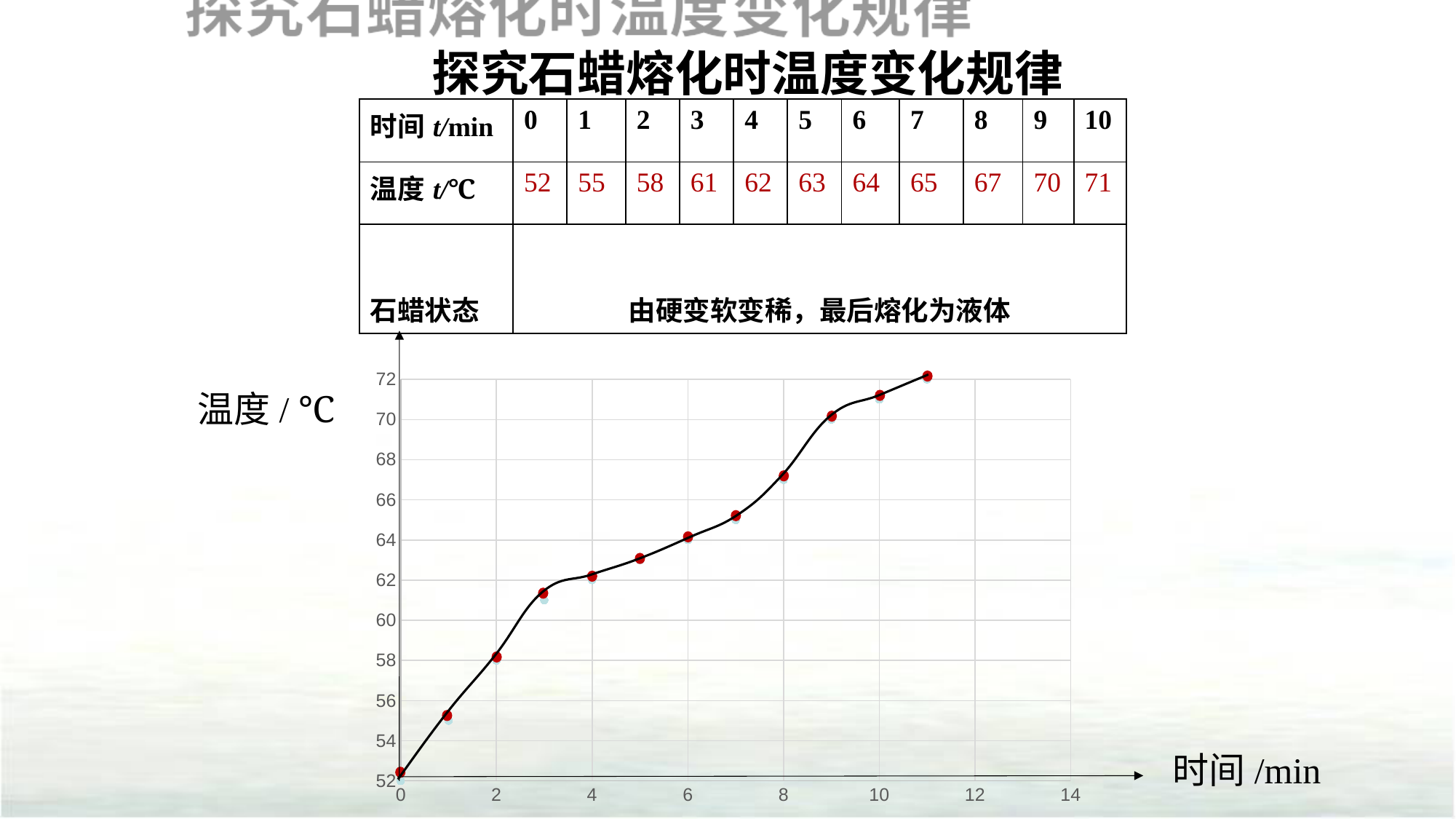
Is the plotted temperature at 6 min greater or less than 66? less According to the table on the slide, what is the temperature at 9 min? 70 Do the plotted temperature values rise or fall as time increases along the x axis? rise At which time is the plotted temperature lowest? 0 min What is the label of the vertical axis of the chart? 温度 / ℃ Is the plotted temperature at 2 min greater or less than 60? less Which is higher, the plotted temperature at 3 min or at 8 min? 8 min How many data points are plotted on the line chart? 12 Is the plotted temperature at 9 min greater or less than 68? greater What kind of chart is shown on the slide? line chart According to the table on the slide, what is the temperature at 5 min? 63 Using the table values, what is the difference between the temperature at 10 min and at 0 min? 19